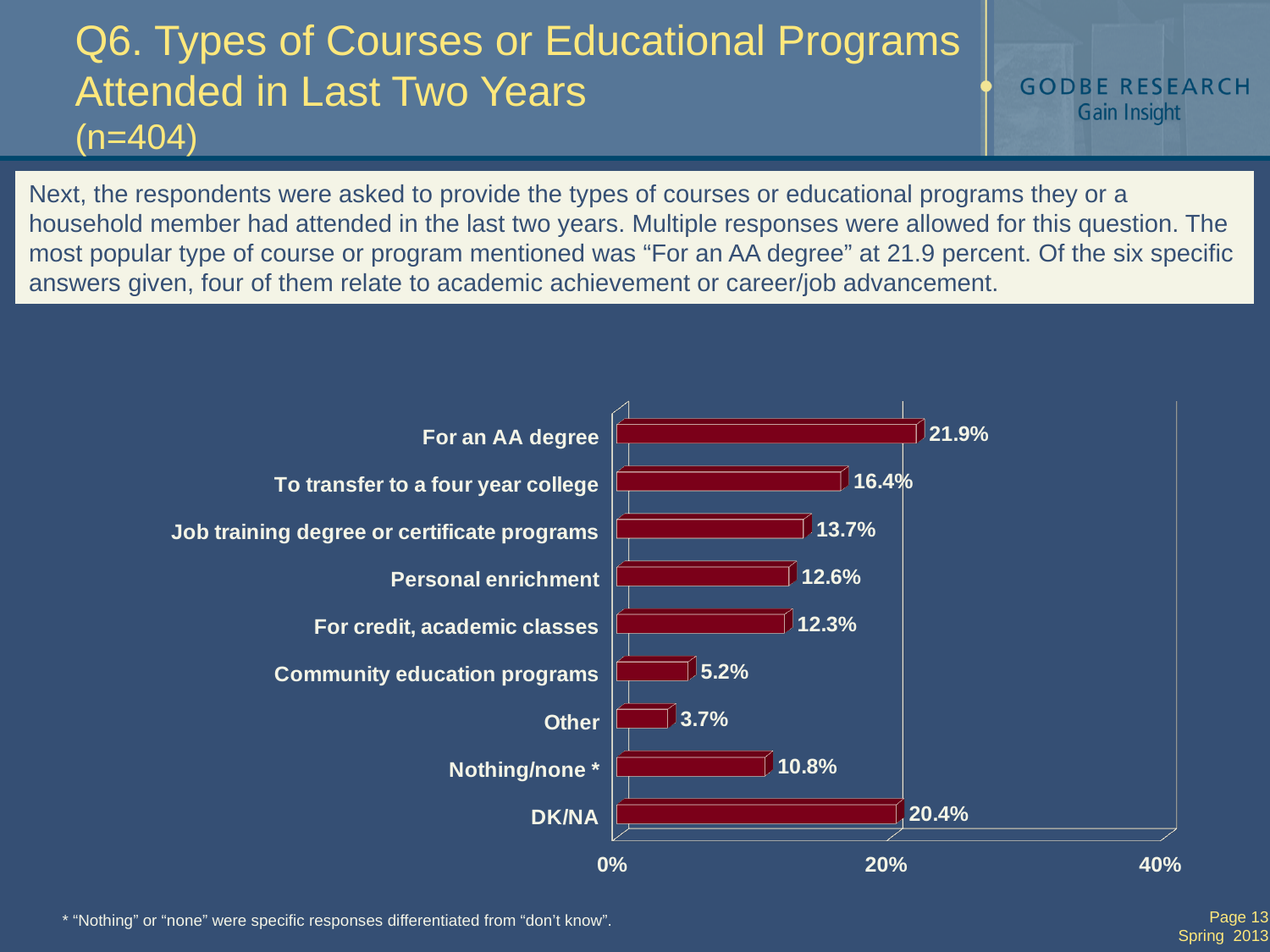
What kind of chart is shown on the slide? Bar chart How many categories are shown in the chart? 9 What is the difference between 'DK/NA' and 'Nothing/none *'? 9.6% Which category has the lowest value in the chart? Other What percentage is shown for 'Nothing/none *'? 10.8% What is the highest value labelled on the horizontal axis? 40% What is the difference between the values for 'For an AA degree' and 'To transfer to a four year college'? 5.5% Which is larger: 'Job training degree or certificate programs' or 'Community education programs'? Job training degree or certificate programs Which category has the highest value in the chart? For an AA degree What percentage of respondents attended courses for an AA degree? 21.9% Is the value for 'DK/NA' greater or less than 20%? greater What is the value shown for 'Personal enrichment'? 12.6%